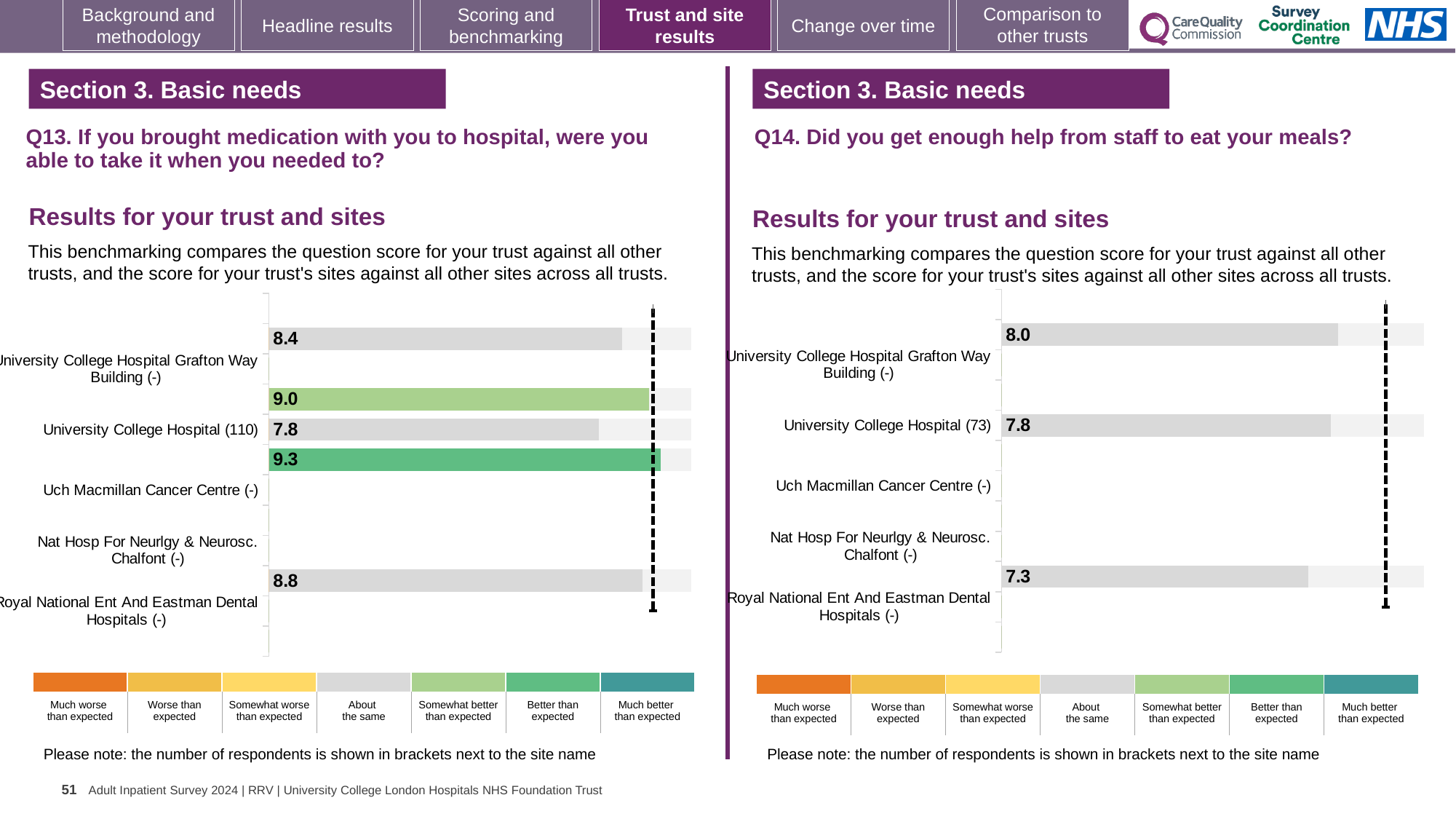
On the Q13 chart (left), what is the lowest score shown on any bar? 7.8 On the Q14 chart (right), what is the score for University College Hospital (73)? 7.8 On the Q14 chart (right), what is the difference between the highest score (8.0) and the lowest score (7.3)? 0.7 On the Q14 chart (right), what is the highest score shown on any bar? 8.0 On the Q14 chart (right), how many bars with data labels are plotted? 3 How many categories does the colour key below the Q14 chart (right) list? 7 What type of chart is used on the Q13 chart (left)? Bar chart On the Q14 chart (right), what is the lowest score shown on any bar? 7.3 On the Q13 chart (left), what is the difference between the highest score (9.3) and the lowest score (7.8)? 1.5 On the Q13 chart (left), how many bars with data labels are plotted? 5 On the Q13 chart (left), what is the highest score shown on any bar? 9.3 On the Q13 chart (left), what is the score for University College Hospital (110)? 7.8